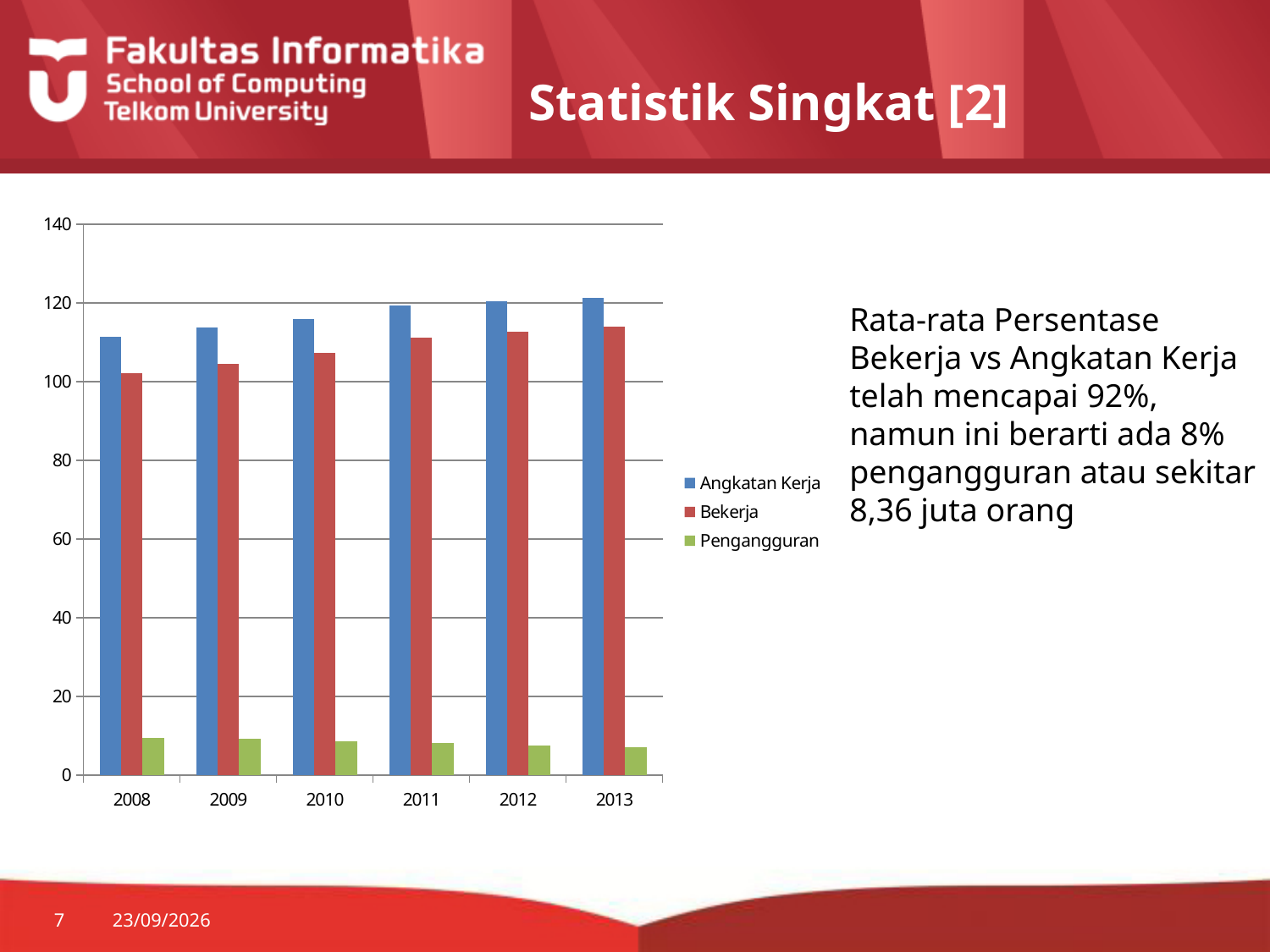
Is the Bekerja value for 2013 greater or less than 120? less In which year is the Angkatan Kerja value lowest? 2008 Do the Pengangguran values rise or fall from 2008 to 2013? fall What kind of chart is shown on the slide? bar chart Is the Bekerja value for 2010 greater or less than 100? greater Is the Angkatan Kerja value for 2008 greater or less than 100? greater How many years are shown on the x axis of the chart? 6 How many series does the chart legend list? 3 In 2011, which is larger: Angkatan Kerja or Bekerja? Angkatan Kerja Which series does the green bar represent in the chart? Pengangguran Do the Angkatan Kerja values rise or fall from 2008 to 2013? rise